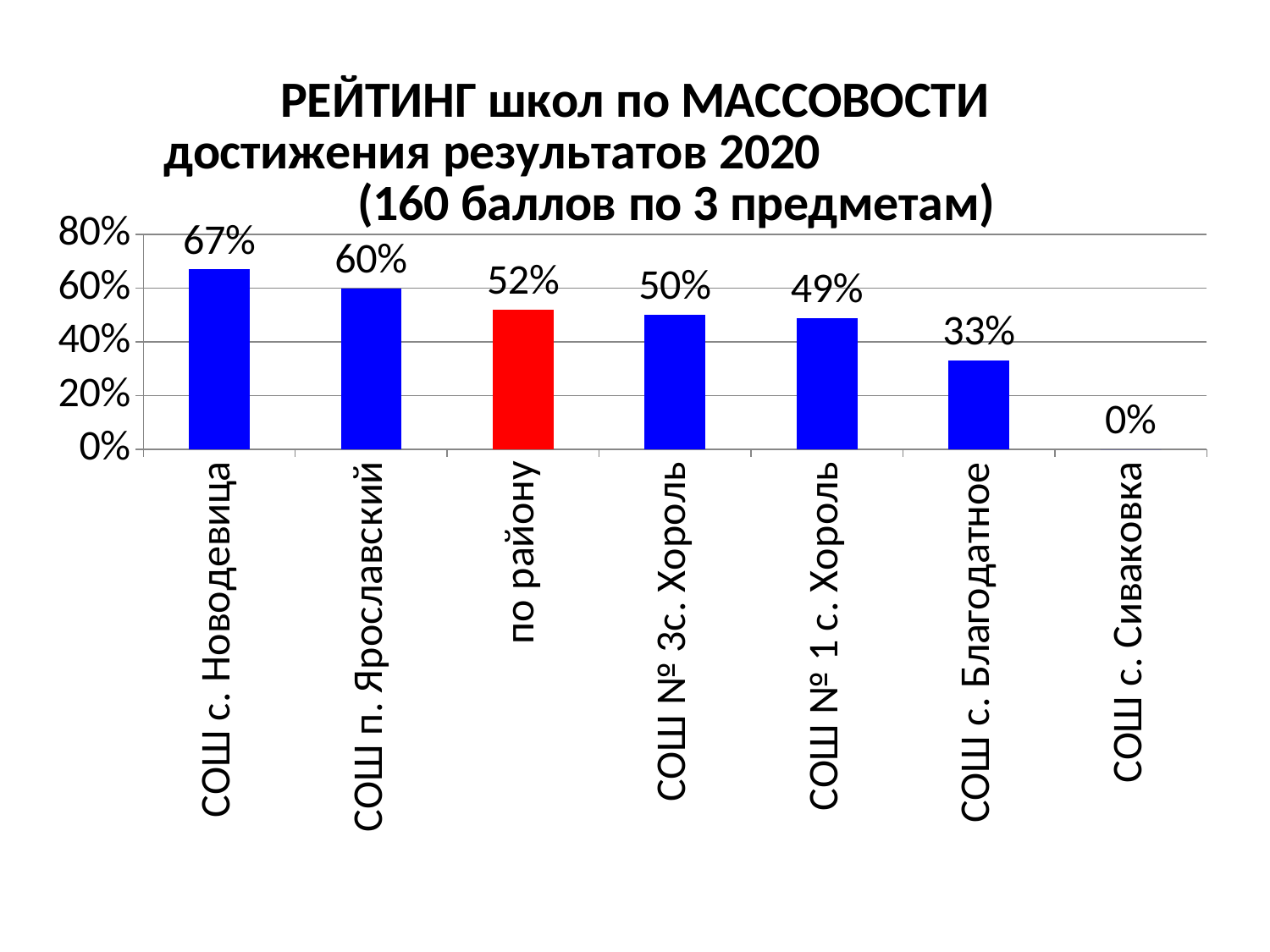
How many categories are shown on the x axis? 7 What is the value for СОШ с. Благодатное? 33% Which is larger, the value for СОШ п. Ярославский or the value for СОШ № 1 с. Хороль? СОШ п. Ярославский Which category has the lowest value? СОШ с. Сиваковка What is the value for СОШ с. Новодевица? 67% Which category has the highest value? СОШ с. Новодевица What is the difference between the values for СОШ с. Новодевица and СОШ с. Благодатное? 34% What is the value for по району? 52% Which bar is coloured red? по району What is the value for СОШ п. Ярославский? 60% What kind of chart is shown on the slide? bar chart Do the values rise or fall from left to right along the x axis? fall